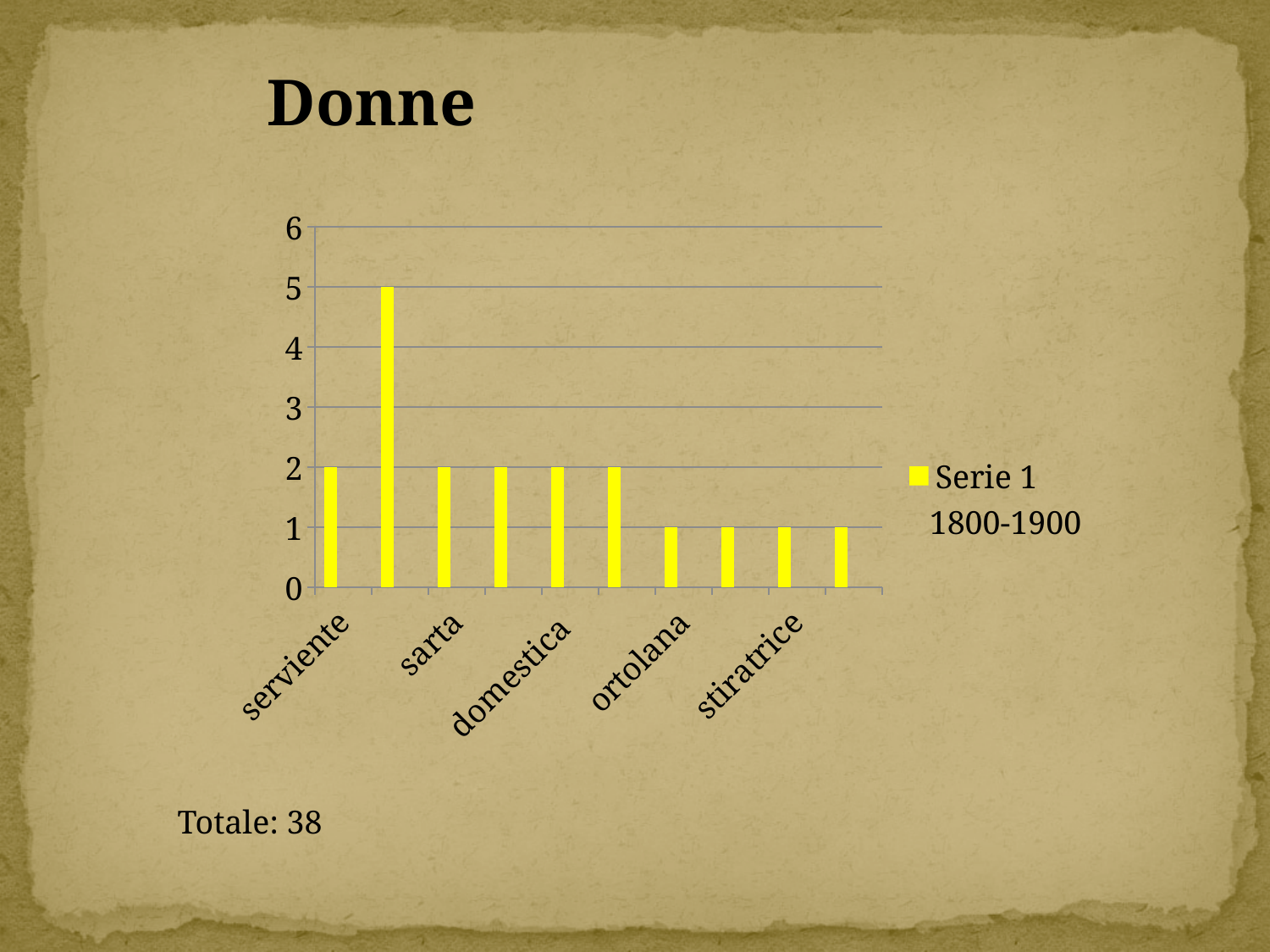
How many bars are plotted in the chart? 10 What is the value for sarta? 2 What is the difference between the value for sarta and the value for stiratrice? 1 How many series does the legend list? 1 What is the value for stiratrice? 1 Which is larger, the value for serviente or the value for ortolana? serviente What is the value for domestica? 2 What is the value for serviente? 2 What is the highest value reached by any bar in the chart? 5 What kind of chart is shown on the slide? bar chart What is the legend entry for the series shown in the chart? Serie 1 1800-1900 What is the value for ortolana? 1